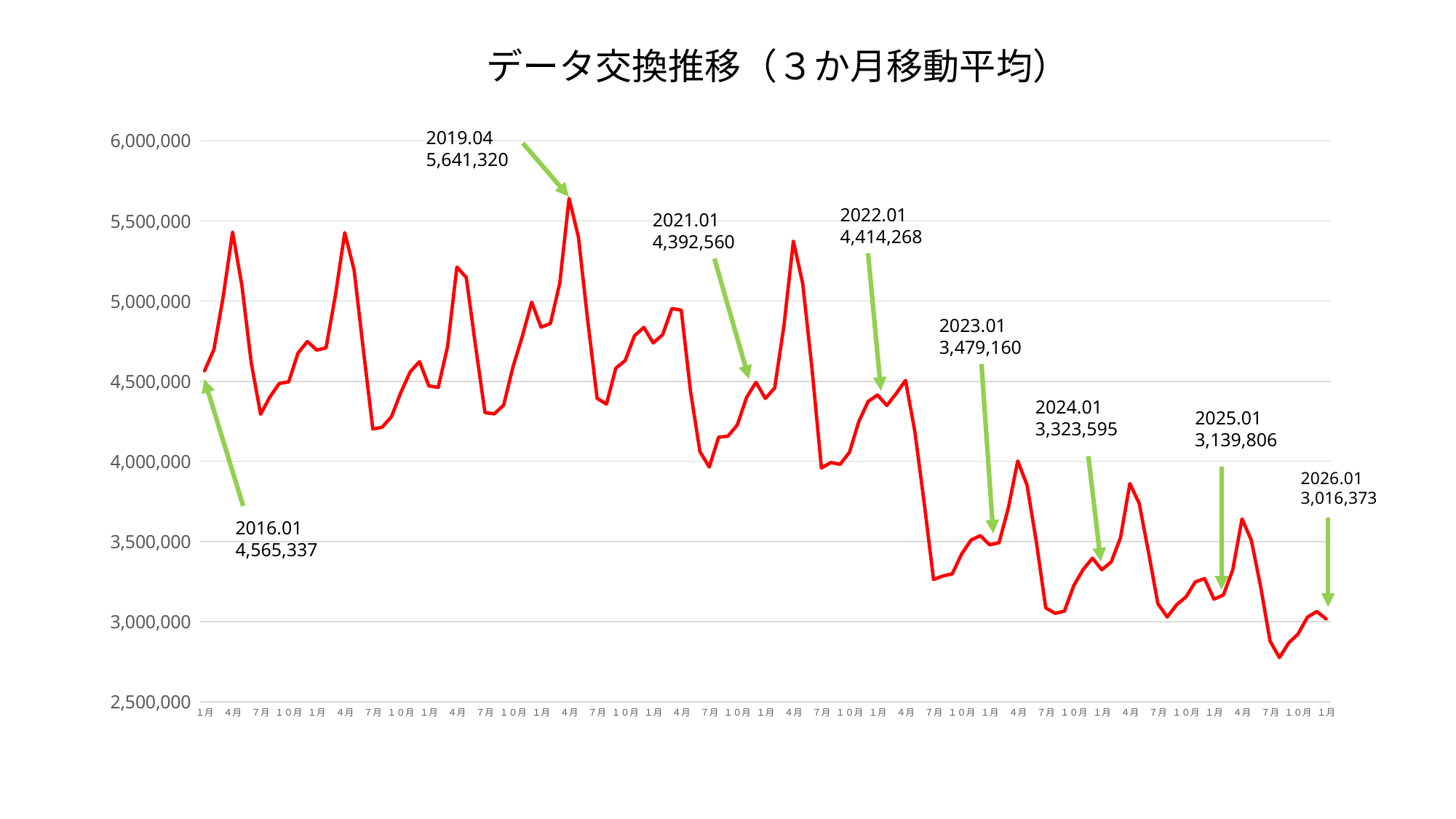
Which annotated point has the lowest value? 2026.01 What type of chart is shown on the slide? line chart What is the difference between the annotated values for 2016.01 and 2026.01? 1,548,964 What is the annotated value for 2026.01? 3,016,373 What is the annotated value for 2016.01? 4,565,337 Overall, does the line rise or fall from 2016.01 to 2026.01? fall What is the title of the chart? データ交換推移（３か月移動平均） Which is larger, the annotated value for 2021.01 or for 2022.01? 2022.01 What is the annotated value for 2023.01? 3,479,160 Is the value at the lowest dip of the line in 2025 (around 7月) greater or less than 3,000,000? less Which annotated point has the highest value? 2019.04 What is the annotated value for 2019.04? 5,641,320